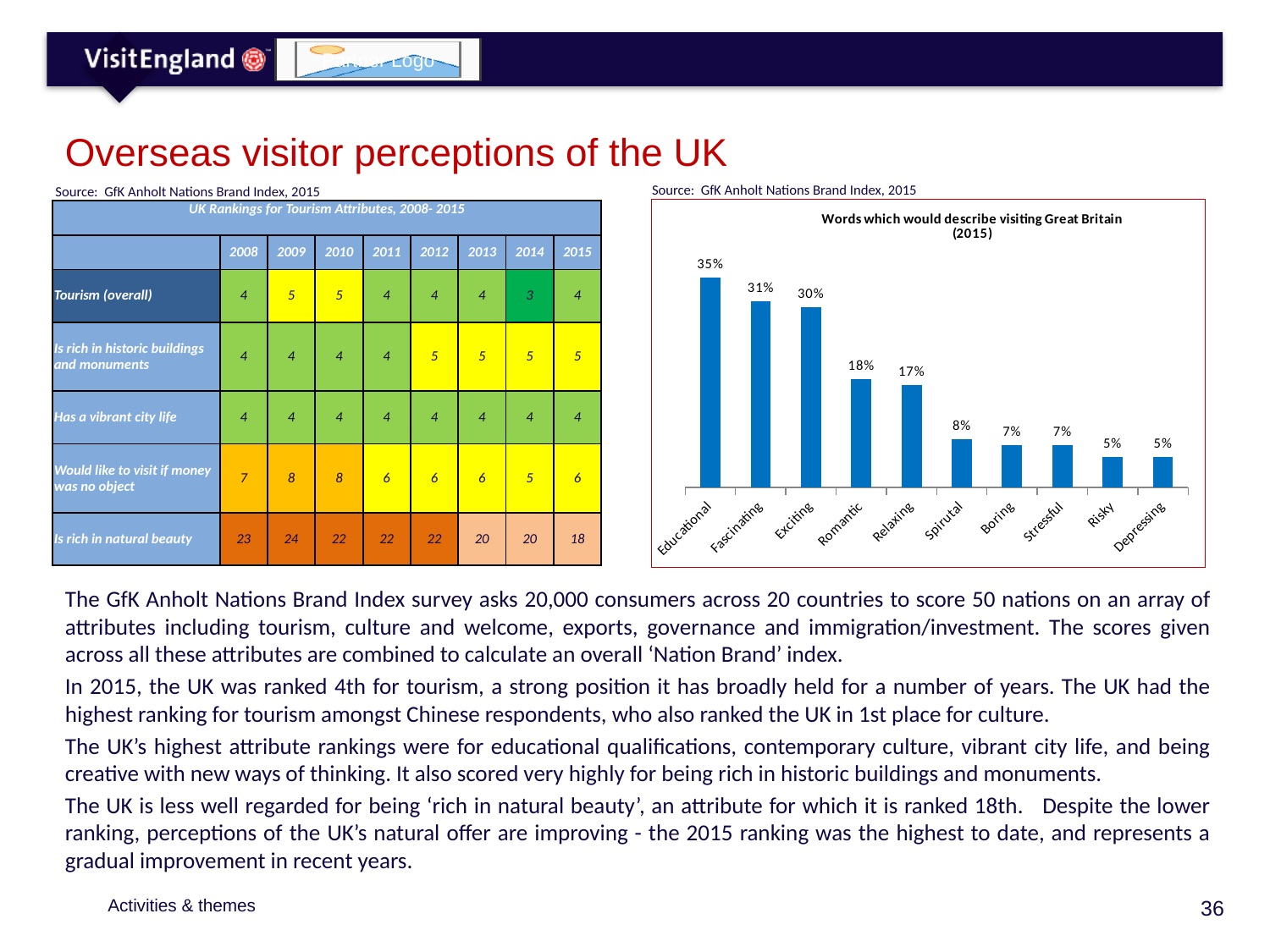
In the chart 'Words which would describe visiting Great Britain (2015)', what percentage is shown for Educational? 35% What type of chart is 'Words which would describe visiting Great Britain (2015)'? Bar chart In the chart 'Words which would describe visiting Great Britain (2015)', how many words are plotted along the x axis? 10 What is the title of the bar chart on the right of the slide? Words which would describe visiting Great Britain (2015) In the chart 'Words which would describe visiting Great Britain (2015)', what percentage is shown for Romantic? 18% In the chart 'Words which would describe visiting Great Britain (2015)', which word has the highest percentage? Educational In the chart 'Words which would describe visiting Great Britain (2015)', what percentage is shown for Boring? 7% In the chart 'Words which would describe visiting Great Britain (2015)', what is the difference between the percentages for Romantic and Relaxing? 1 percentage point In the chart 'Words which would describe visiting Great Britain (2015)', which has the larger percentage, Exciting or Relaxing? Exciting In the chart 'Words which would describe visiting Great Britain (2015)', what percentage is shown for Depressing? 5% In the chart 'Words which would describe visiting Great Britain (2015)', do the values rise or fall moving from left to right along the x axis? Fall In the chart 'Words which would describe visiting Great Britain (2015)', what is the difference between the percentages for Educational and Fascinating? 4 percentage points